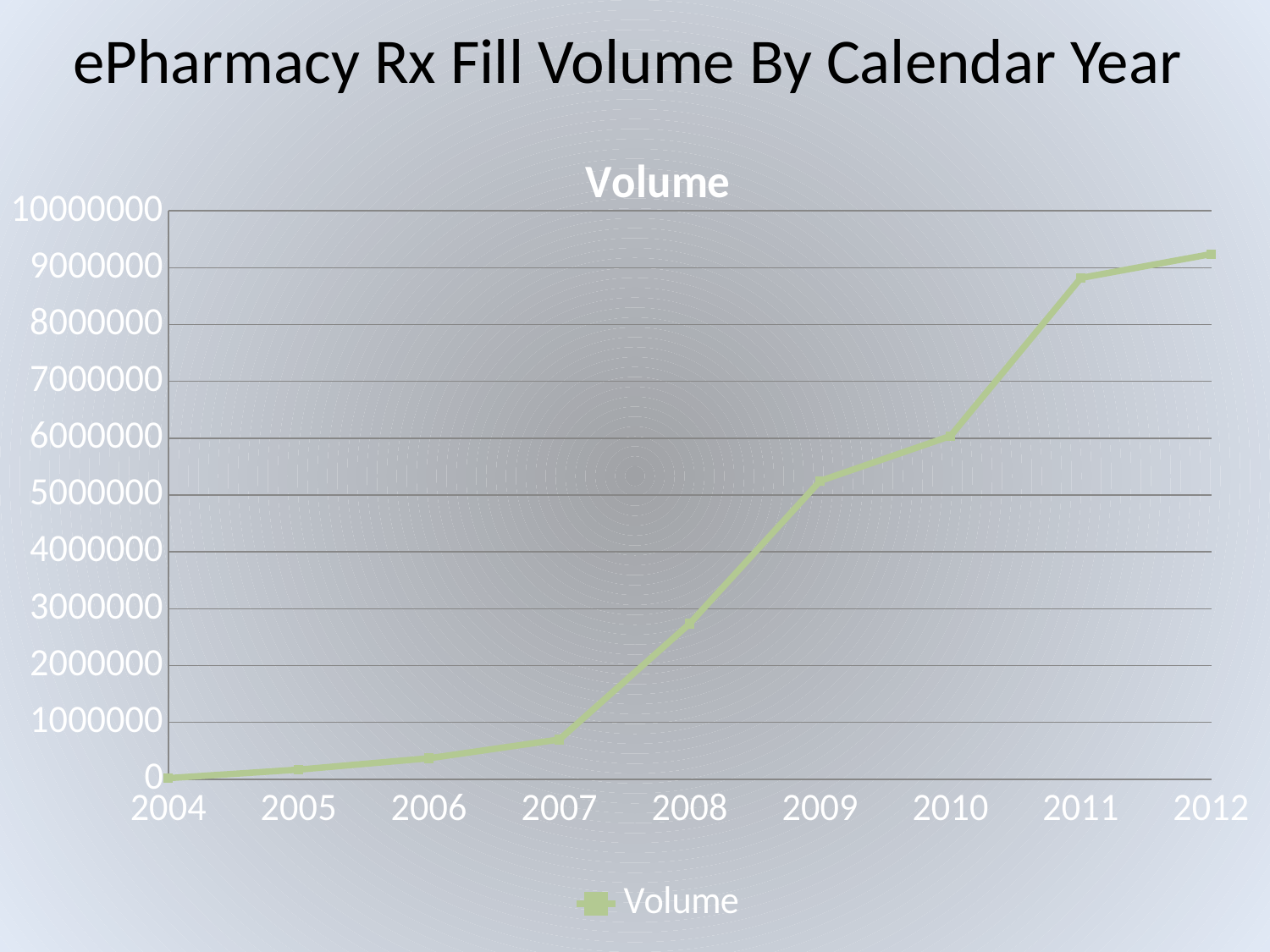
Is the value for 2007 greater or less than 1000000? less Is the value for 2009 greater or less than 4000000? greater Is the value for 2011 greater or less than 8000000? greater Which year has the highest volume? 2012 Which year has the lowest volume? 2004 Do the volume values rise or fall from 2004 to 2012? rise Which year has the larger volume, 2008 or 2009? 2009 What is the title of the chart? Volume How many series does the legend list? 1 How many years are plotted on the x axis? 9 What kind of chart is shown on the slide? line chart